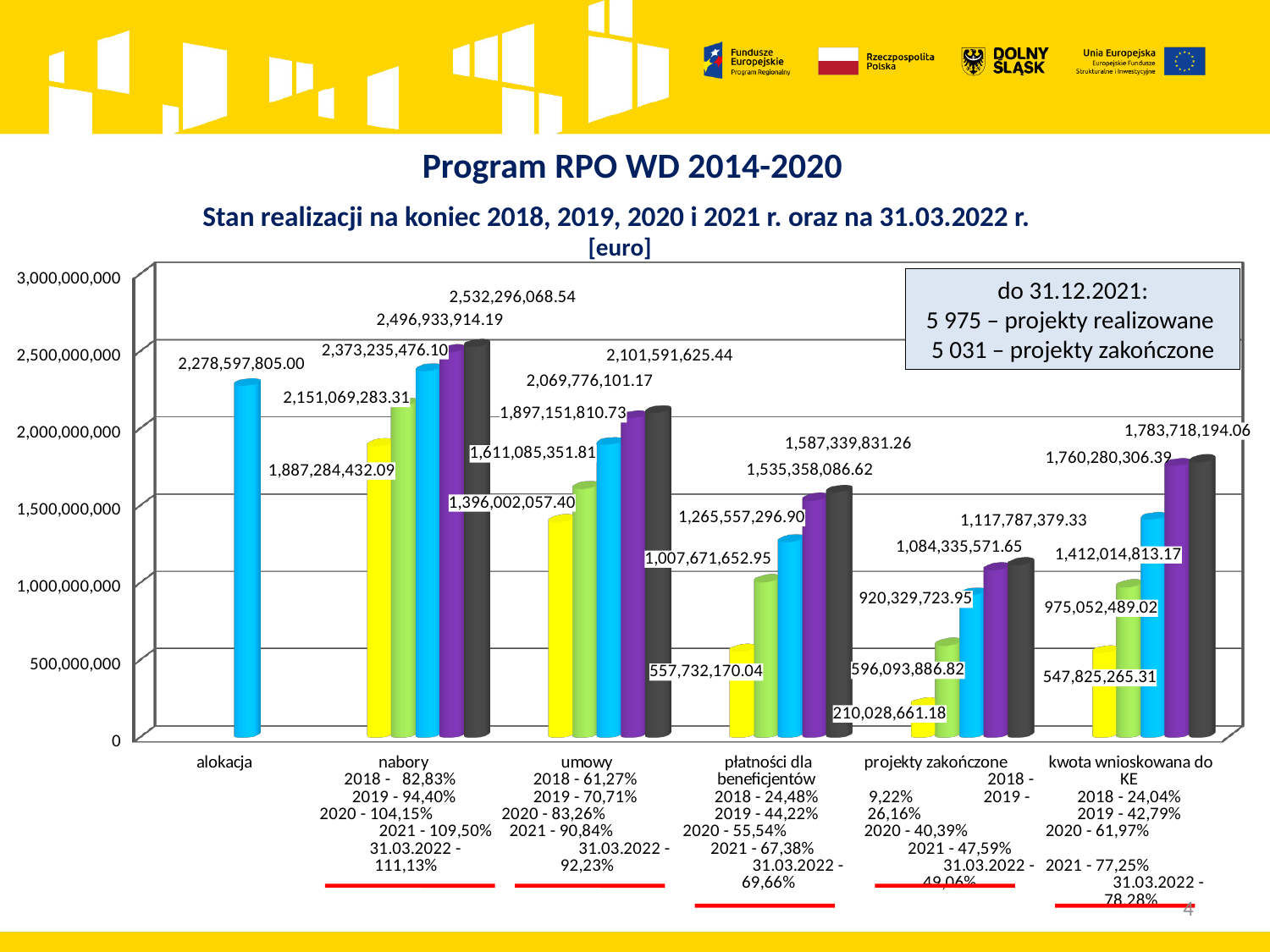
Is the lowest bar in the kwota wnioskowana do KE group greater or less than 1,000,000,000? less Which is larger: the highest value in the umowy group or the highest value in the płatności dla beneficjentów group? umowy What unit is given in the chart title? euro What kind of chart is this? bar chart What is the lowest value labelled in the płatności dla beneficjentów group? 557,732,170.04 What is the highest value labelled in the nabory group? 2,532,296,068.54 What is the lowest value labelled in the projekty zakończone group? 210,028,661.18 What is the highest value labelled in the kwota wnioskowana do KE group? 1,783,718,194.06 What is the value shown for alokacja? 2,278,597,805.00 How many categories are shown on the x axis? 6 What is the difference between the highest and lowest labelled values in the nabory group? 645,011,636.45 Within the umowy group, do the bars rise or fall from left to right? rise